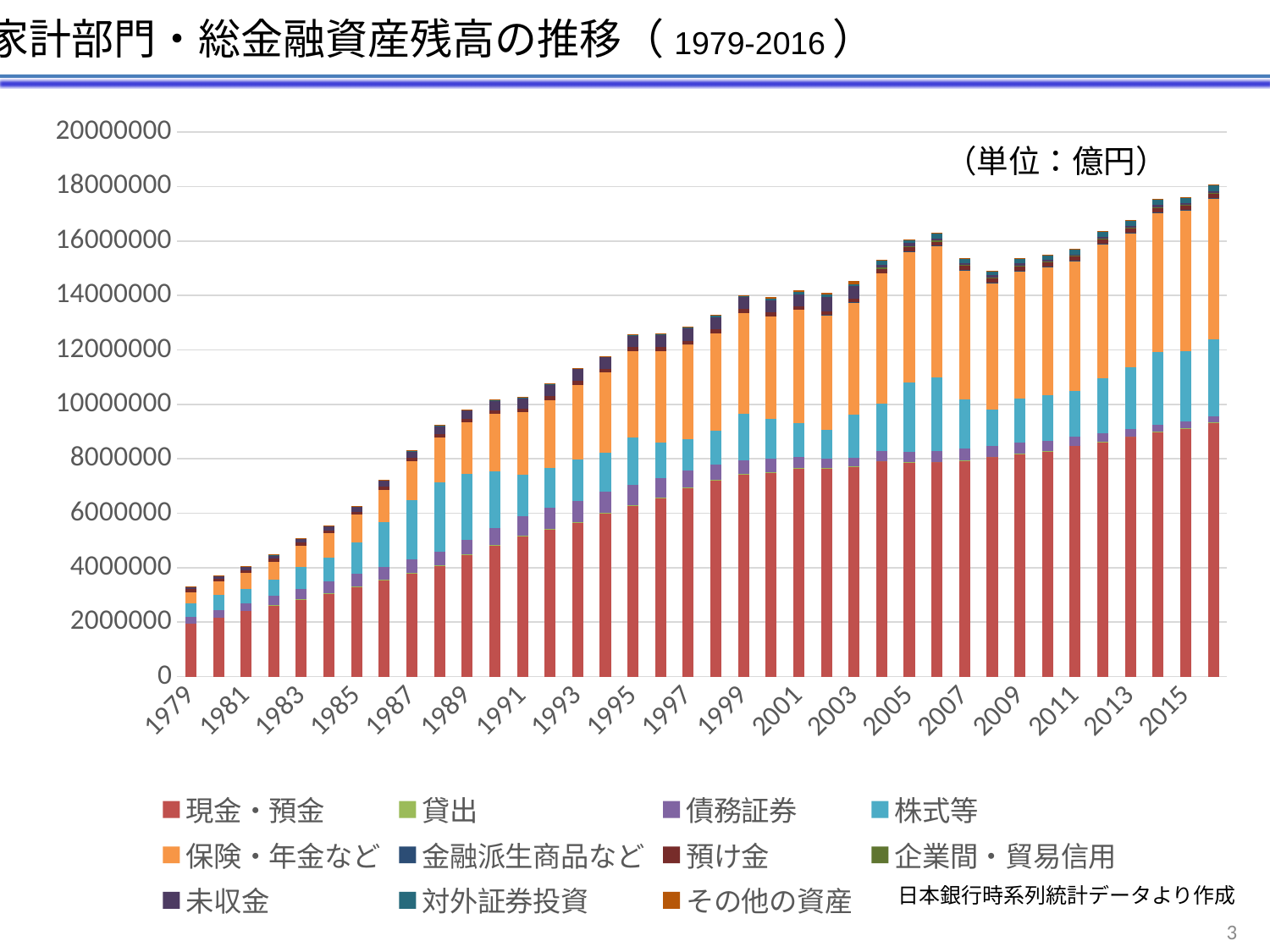
Is the total for 1979 greater or less than 4000000? less Which series is listed first in the legend? 現金・預金 Do the total bar heights generally rise or fall from 1979 to 2016? Rise Which year has the lowest total bar? 1979 How many yearly bars are plotted in the chart (1979 through 2016)? 38 What unit is stated for the values in the chart? 億円 How many series does the legend list? 11 Is the total for 2016 greater or less than 16000000? greater What kind of chart is shown on the slide? Stacked bar chart Which year has the highest total bar? 2016 Is the total for 2005 greater or less than 14000000? greater